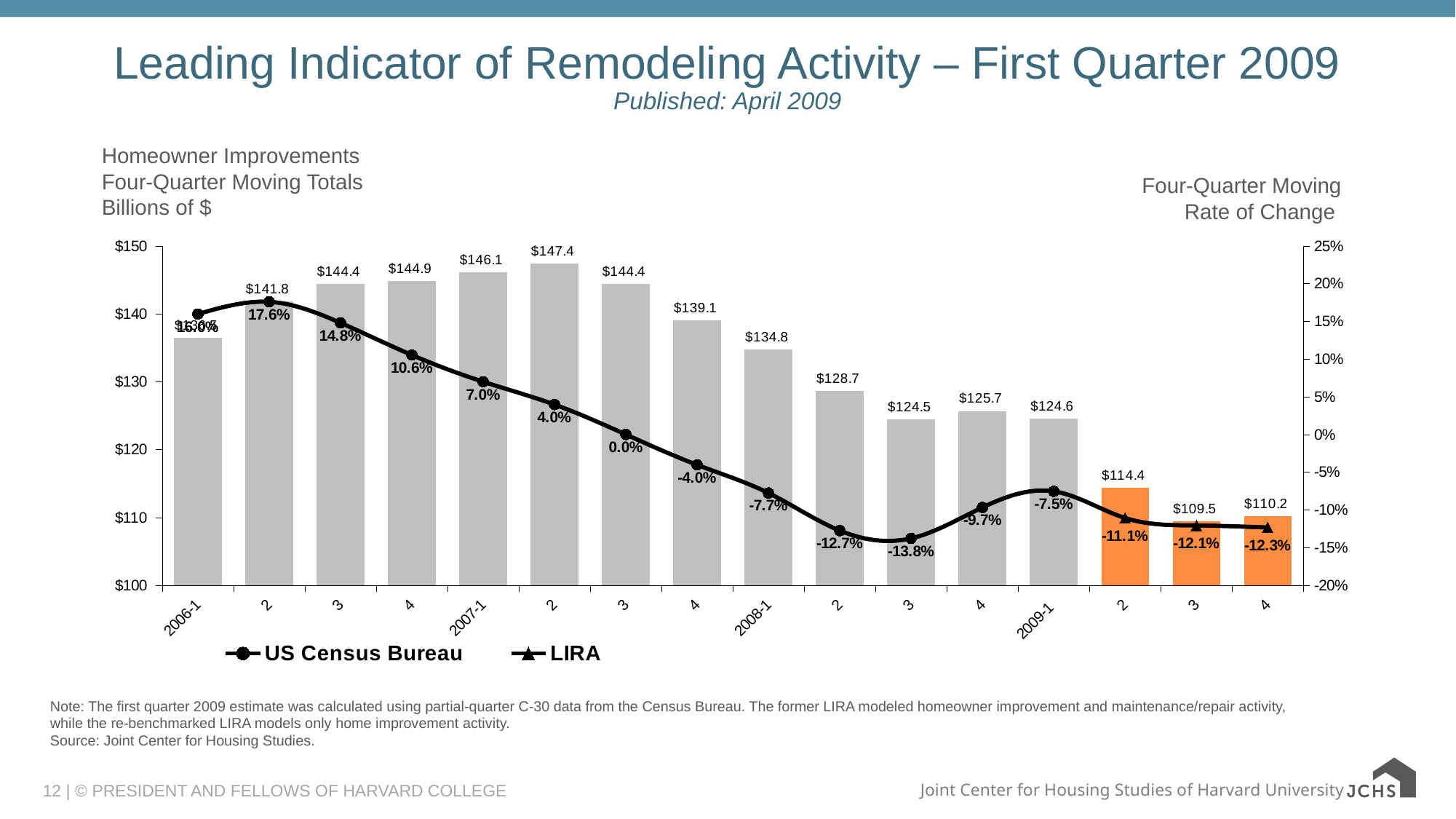
How many series does the legend list? 2 Which quarter has the lowest four-quarter moving total of homeowner improvements? 2009-3 Which is larger, the four-quarter moving total for 2008-4 or for 2009-1? 2008-4 What is the four-quarter moving rate of change shown for 2008-3? -13.8% Which quarter has the highest four-quarter moving total of homeowner improvements? 2007-2 What is the four-quarter moving total of homeowner improvements for 2007-2? $147.4 What is the difference between the four-quarter moving totals for 2007-2 and 2009-3? $37.9 What is the overall trend of the four-quarter moving totals from 2007-2 to 2009-3? Falling Which quarter has the lowest four-quarter moving rate of change? 2008-3 What are the two series named in the legend? US Census Bureau and LIRA What is the four-quarter moving total shown for the 2009-4 bar? $110.2 How many quarters (bars) are plotted on the chart? 16